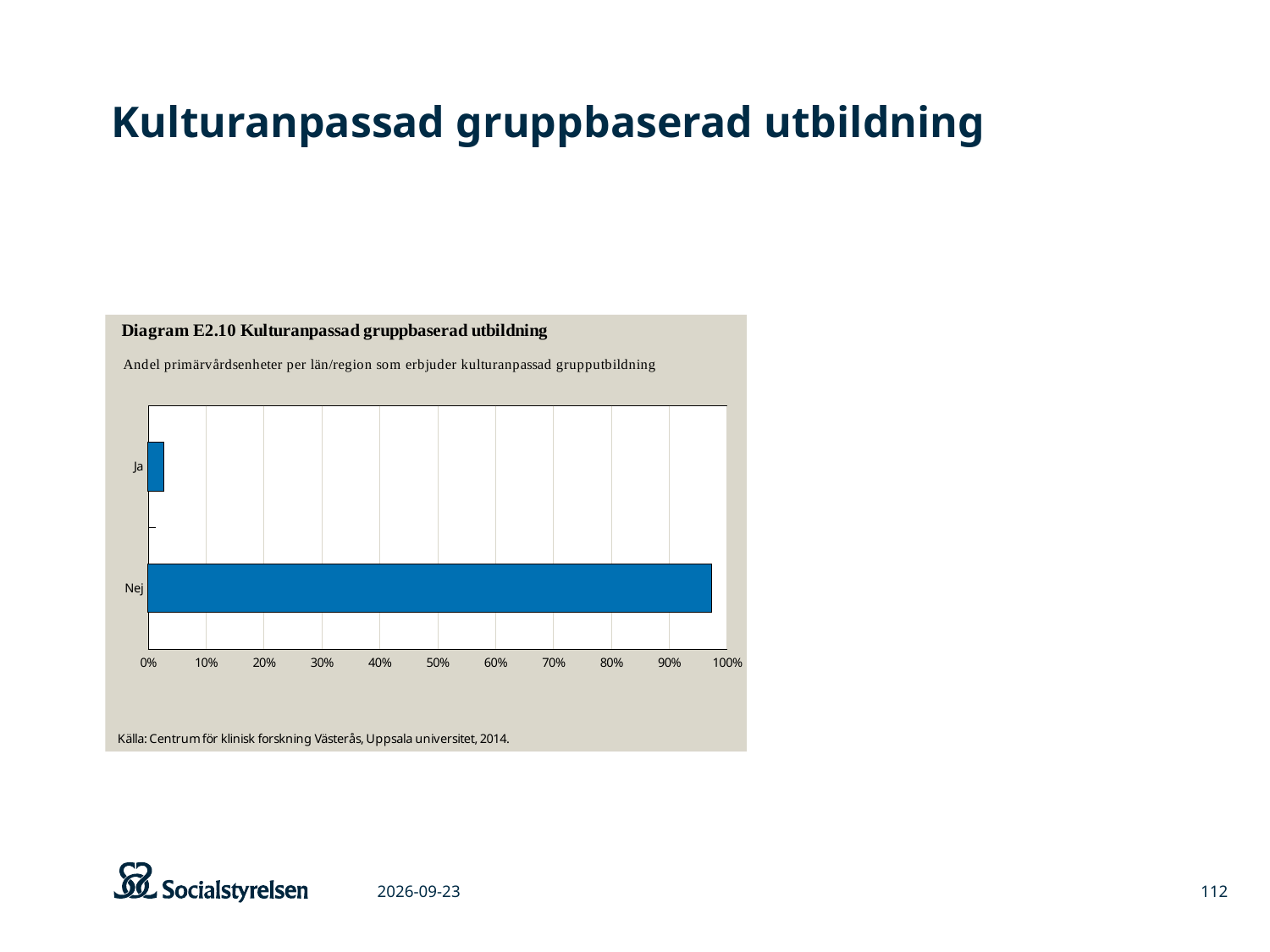
Is the value for Ja greater or less than 10%? less Is the value for Nej greater or less than 90%? greater Is the value for Nej greater or less than 50%? greater What is the highest value shown on the x axis of the chart? 100% Which category has the highest value in the chart? Nej What kind of chart is shown on the slide? bar chart What is the title of the diagram shown on the slide? Diagram E2.10 Kulturanpassad gruppbaserad utbildning Which category has the lowest value in the chart? Ja Which is larger, the value for Ja or the value for Nej? Nej How many categories are plotted in the chart? 2